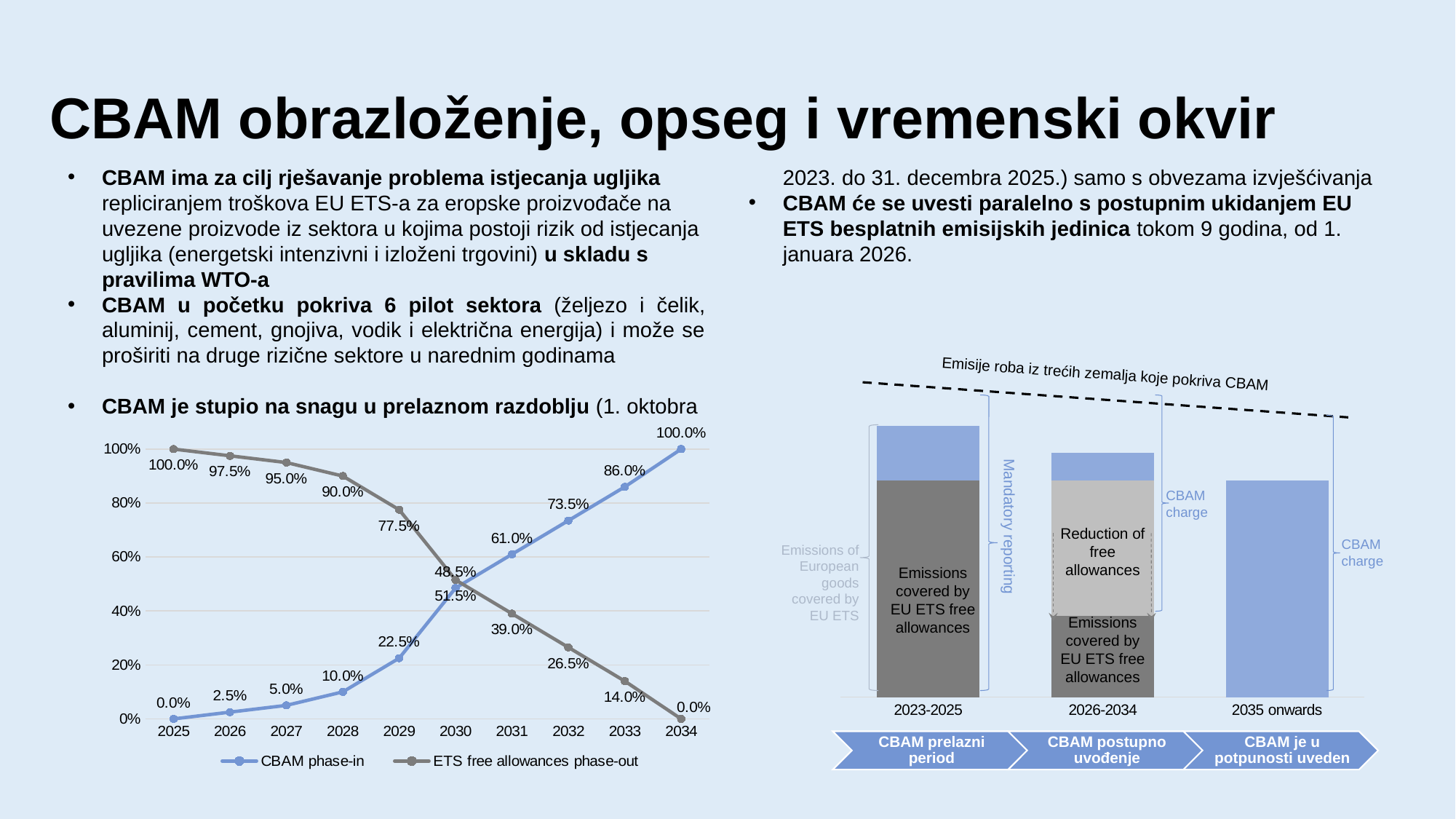
On the line chart on the left, what is the difference between the CBAM phase-in values for 2033 and 2032? 12.5% On the line chart on the left, how many series does the legend list? 2 On the line chart on the left, what is the ETS free allowances phase-out value for 2028? 90.0% What kind of chart is shown on the left of the slide? line chart On the line chart on the left, how many years are shown on the x axis? 10 On the line chart on the left, in which year is the ETS free allowances phase-out value lowest? 2034 On the line chart on the left, which is larger in 2030: the CBAM phase-in value or the ETS free allowances phase-out value? ETS free allowances phase-out On the line chart on the left, in which year is the CBAM phase-in value highest? 2034 On the line chart on the left, what is the CBAM phase-in value for 2032? 73.5% On the line chart on the left, what is the CBAM phase-in value for 2029? 22.5% On the line chart on the left, does the ETS free allowances phase-out series rise or fall from 2025 to 2034? fall On the line chart on the left, what is the ETS free allowances phase-out value for 2031? 39.0%